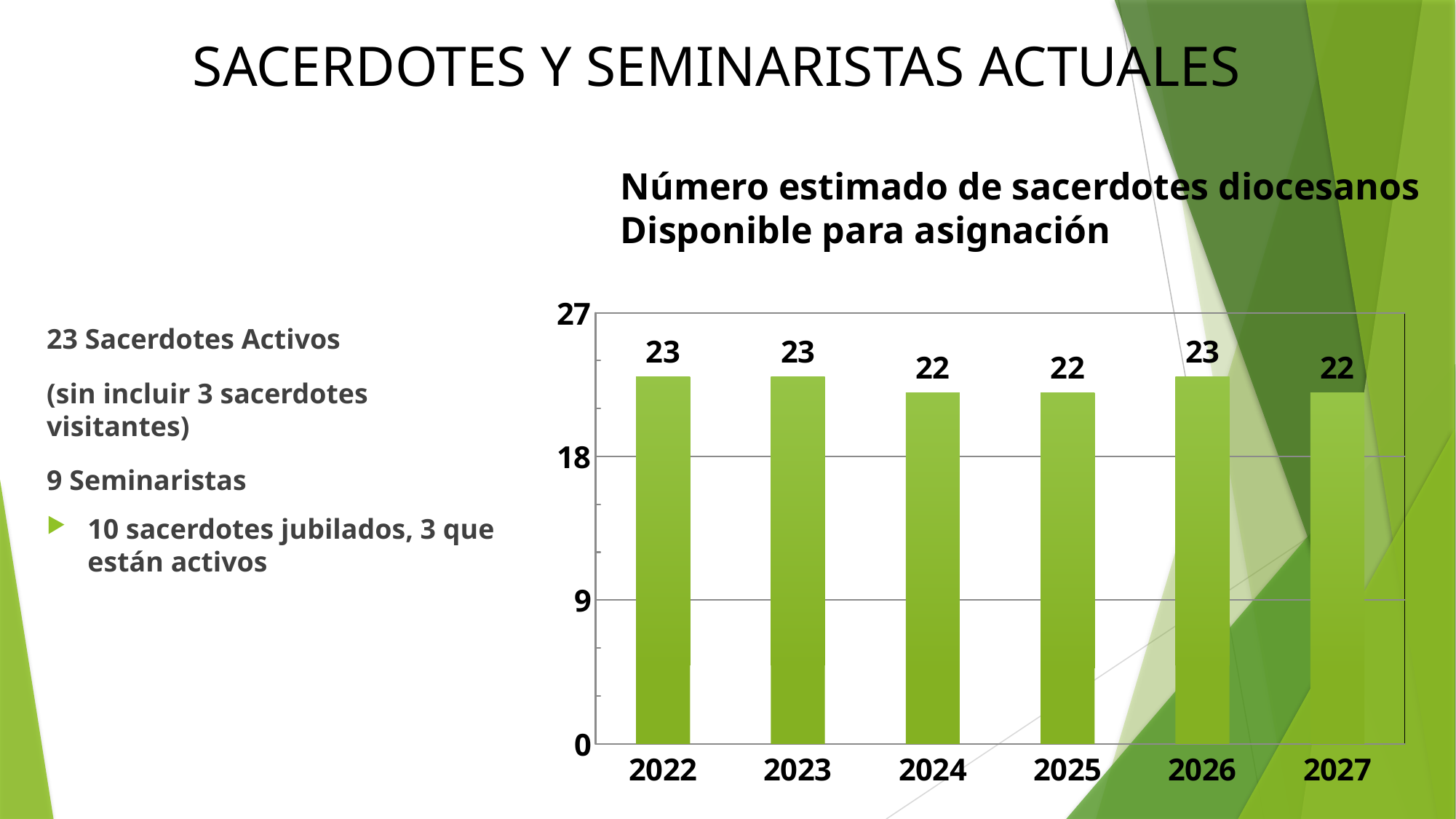
How many years have a value of 22? 3 What is the value for 2022? 23 What is the highest value shown on the y axis? 27 What is the value for 2024? 22 What kind of chart is shown? bar chart What is the title of the chart? Número estimado de sacerdotes diocesanos Disponible para asignación What is the value for 2027? 22 What is the value for 2026? 23 How many years are shown on the x axis? 6 Is the value for 2025 greater or less than 18? greater What is the difference between the values for 2023 and 2024? 1 Which is larger, the value for 2025 or the value for 2026? 2026